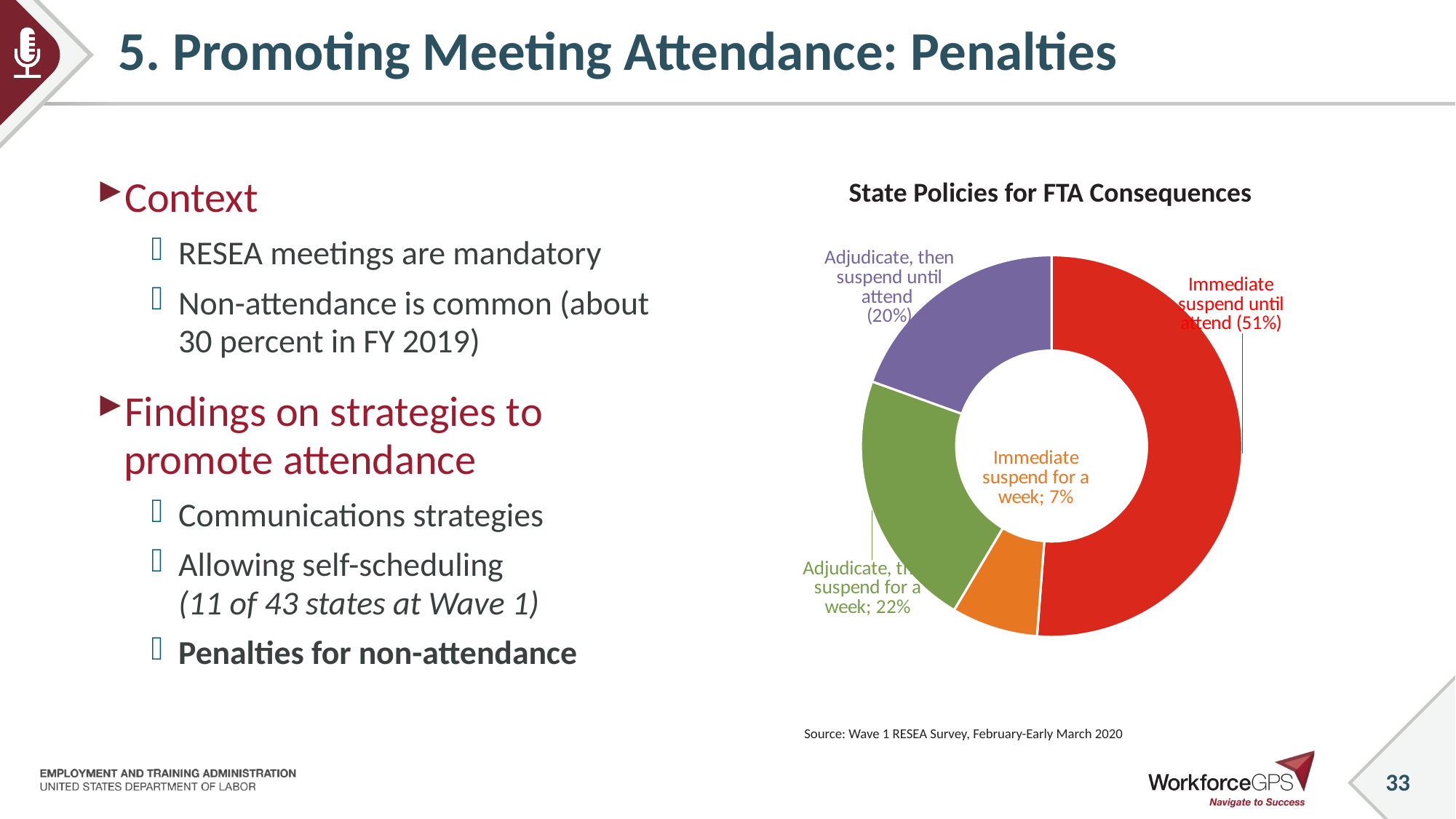
Which policy category has the largest share of the pie? Immediate suspend until attend What share of states have a policy of 'Adjudicate, then suspend until attend'? 20% What kind of chart is shown on the slide? Pie chart (doughnut) What is the title of the chart on the slide? State Policies for FTA Consequences What share of states have a policy of 'Immediate suspend until attend'? 51% Which is larger: the share for 'Adjudicate, then suspend for a week' or the share for 'Adjudicate, then suspend until attend'? Adjudicate, then suspend for a week What share of states have a policy of 'Immediate suspend for a week'? 7% What share of states have a policy of 'Adjudicate, then suspend for a week'? 22% Which policy category has the smallest share of the pie? Immediate suspend for a week What is the difference in percentage points between 'Immediate suspend until attend' and 'Adjudicate, then suspend for a week'? 29 percentage points What colour is the slice for 'Immediate suspend until attend'? Red How many categories are shown in the pie chart? 4